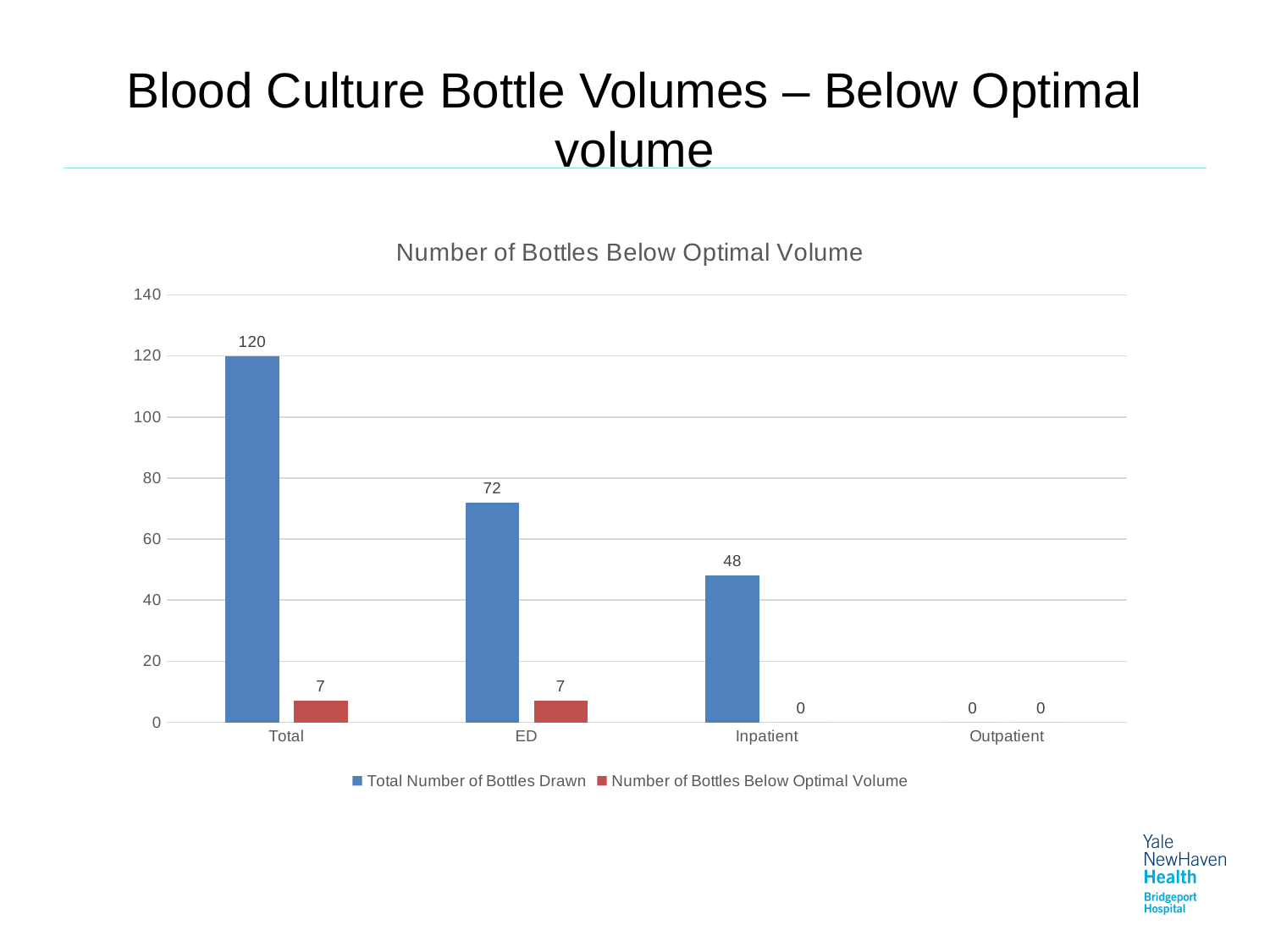
What is the Number of Bottles Below Optimal Volume for Inpatient? 0 Which category has the highest Total Number of Bottles Drawn? Total What kind of chart is shown on the slide? Bar chart What is the Total Number of Bottles Drawn for Inpatient? 48 Which is larger: the Total Number of Bottles Drawn for ED or for Inpatient? ED What is the title of the chart? Number of Bottles Below Optimal Volume How many categories are shown on the x axis? 4 Which category has the lowest Total Number of Bottles Drawn? Outpatient What is the Number of Bottles Below Optimal Volume for Total? 7 What is the difference between the Total Number of Bottles Drawn for ED and for Inpatient? 24 What is the Total Number of Bottles Drawn for ED? 72 How many series does the legend list? 2